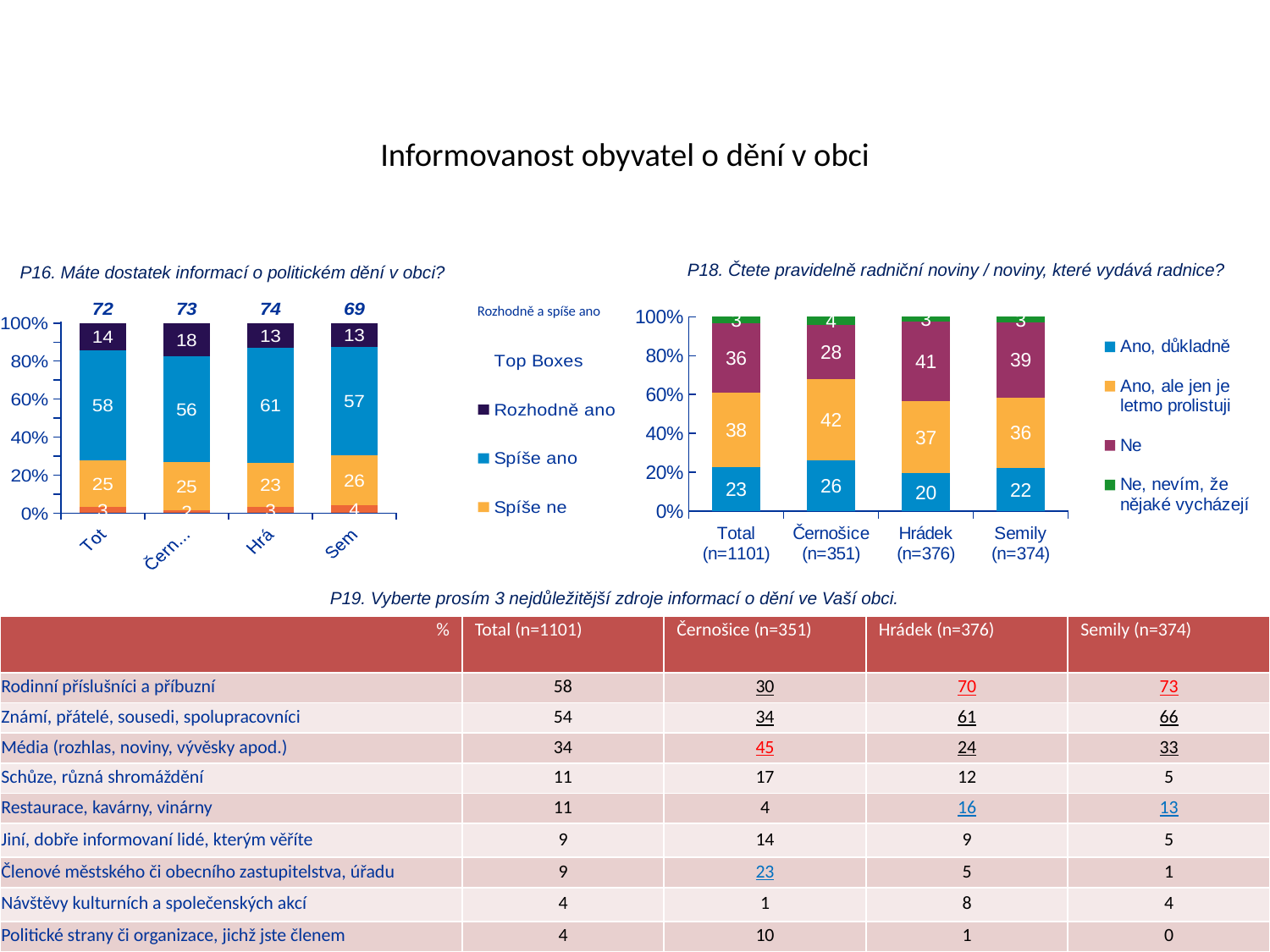
In the P18 chart (right), what is the value of 'Ano, ale jen je letmo prolistuji' for Total (n=1101)? 38 In the P18 chart (right), what is the value of 'Ano, důkladně' for Černošice (n=351)? 26 In the P16 chart (left), what is the 'Spíše ano' value for the Tot bar? 58 In the P16 chart (left), what is the Top Boxes value shown above the Sem bar? 69 In the P18 chart (right), which category has the lowest value for 'Ano, důkladně'? Hrádek (n=376) In the P18 chart (right), how many series does the legend list? 4 In the P18 chart (right), how many categories are shown on the x axis? 4 In the P18 chart (right), what is the value of 'Ne' for Hrádek (n=376)? 41 In the P16 chart (left), which bar has the highest 'Spíše ano' value? Hrá In the P18 chart (right), what is the difference between the 'Ne' values for Hrádek (n=376) and Černošice (n=351)? 13 What kind of chart is the P18 chart on the right? Stacked bar chart In the P18 chart (right), which category has the highest value for 'Ne'? Hrádek (n=376)